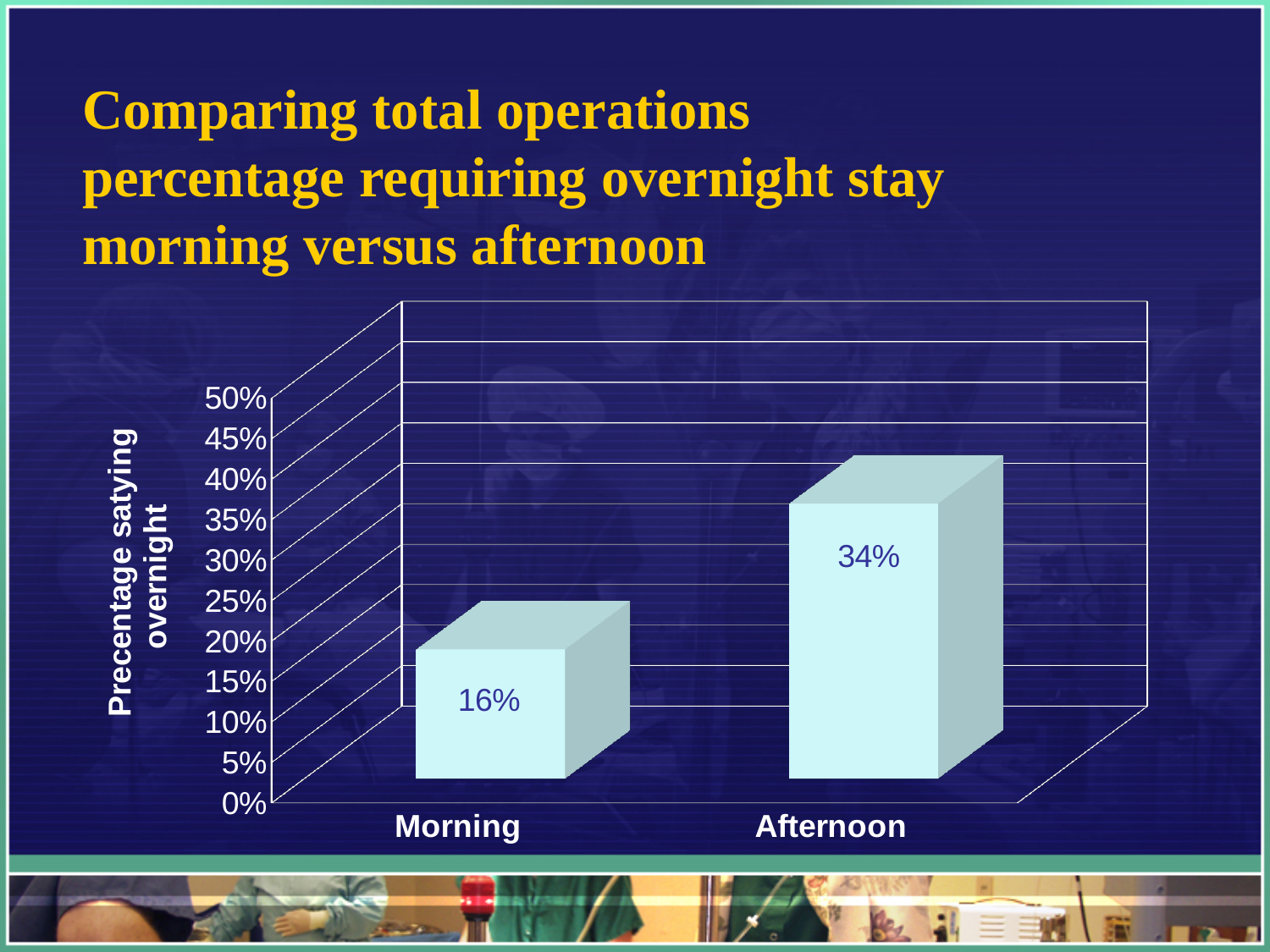
Is the value for Afternoon greater or less than 30%? greater What kind of chart is shown on the slide? Bar chart What is the difference in percentage staying overnight between Afternoon and Morning? 18% What is the percentage staying overnight for Morning operations? 16% Is the percentage staying overnight larger for Morning or Afternoon? Afternoon Which category has the higher percentage staying overnight? Afternoon How many categories are shown on the x axis of the chart? 2 What is the percentage staying overnight for Afternoon operations? 34% Which category has the lower percentage staying overnight? Morning What is the label on the vertical axis of the chart? Precentage satying overnight Is the value for Morning greater or less than 20%? less What is the highest value shown on the vertical axis of the chart? 50%